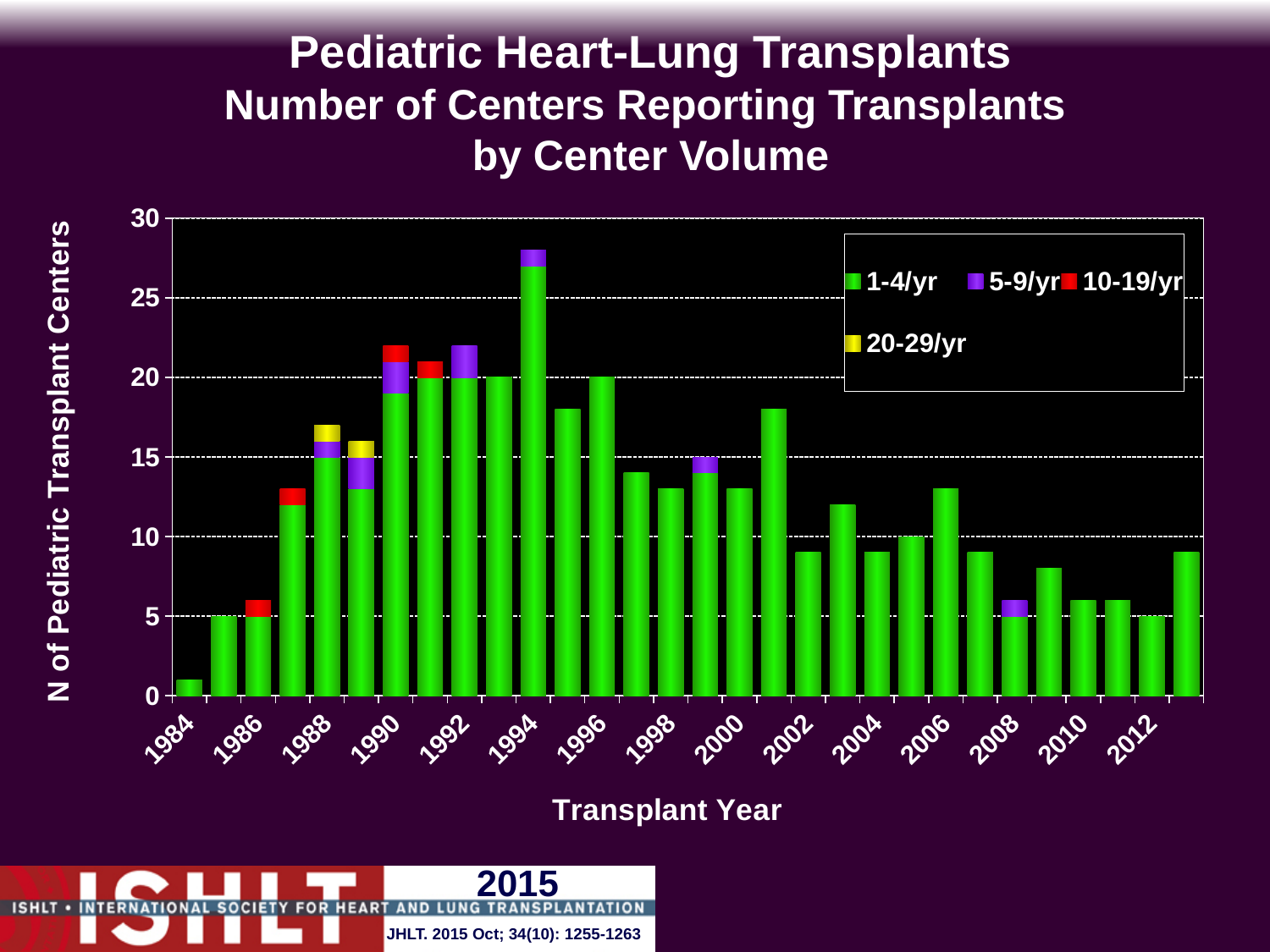
Which transplant year has the lowest number of pediatric transplant centers? 1984 Is the total number of centers for 1994 greater or less than 25? greater Which year has more pediatric transplant centers, 1994 or 2001? 1994 Is the total number of centers for 2001 greater or less than 15? greater Do the number of centers generally rise or fall from 2001 to 2012? fall Is the total number of centers for 2008 greater or less than 10? less How many series does the legend list? 4 Which legend entry is shown in yellow? 20-29/yr What kind of chart is shown on the slide? Stacked bar chart Which transplant year has the highest number of pediatric transplant centers? 1994 Which year has more pediatric transplant centers, 1990 or 2003? 1990